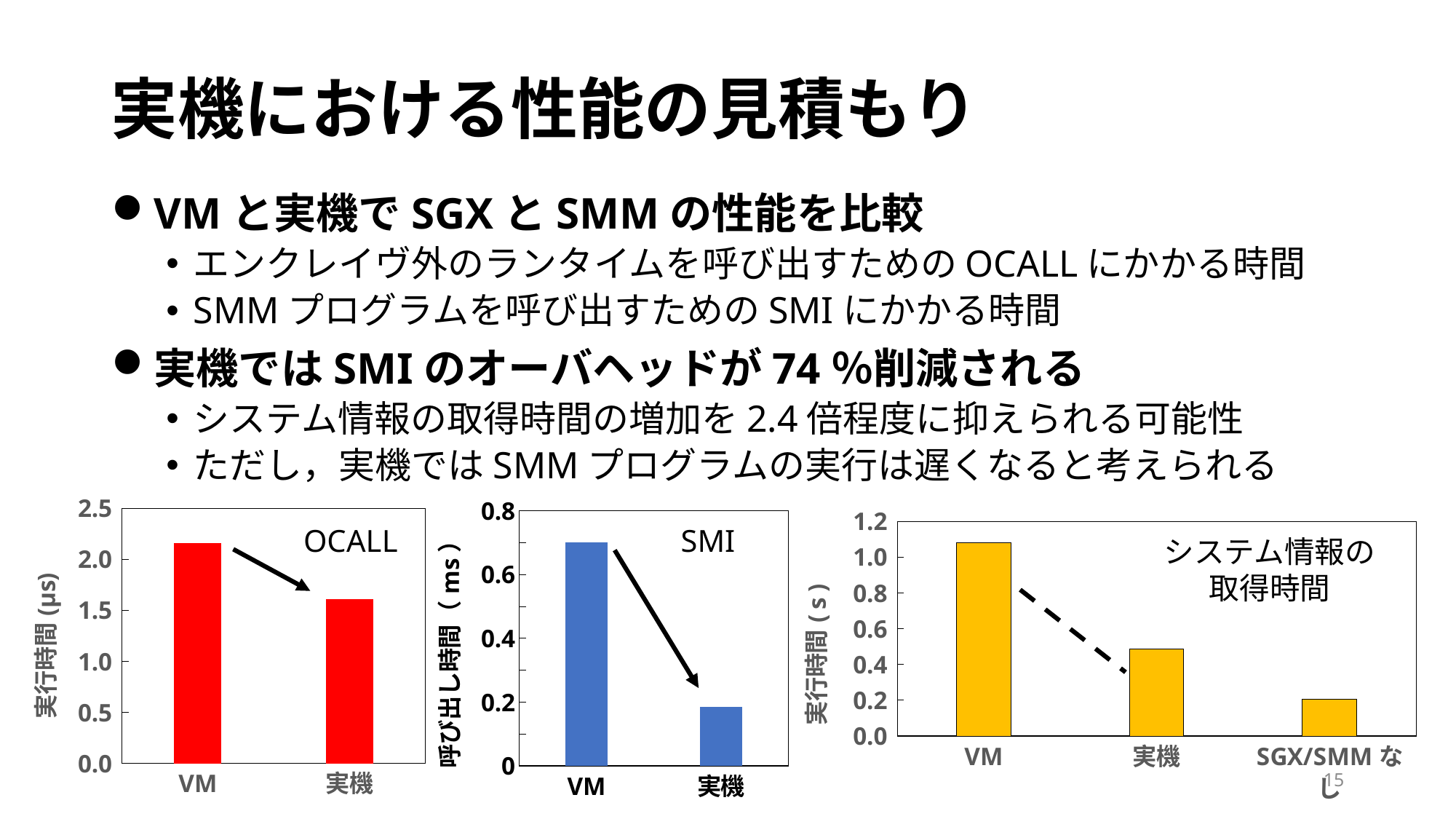
What kind of chart is the SMI chart in the middle? bar chart In the システム情報の取得時間 chart on the right, how many categories are shown on the x axis? 3 In the OCALL chart on the left, which category has the higher execution time? VM In the システム情報の取得時間 chart on the right, which category has the lowest execution time? SGX/SMM なし In the OCALL chart on the left, how many bars are plotted? 2 In the OCALL chart on the left, is the value for VM greater or less than 2.0? greater In the システム情報の取得時間 chart on the right, which category has the highest execution time? VM In the SMI chart in the middle, is the value for 実機 greater or less than 0.4? less In the OCALL chart on the left, is the value for 実機 greater or less than 2.0? less In the SMI chart in the middle, which category has the lower call time? 実機